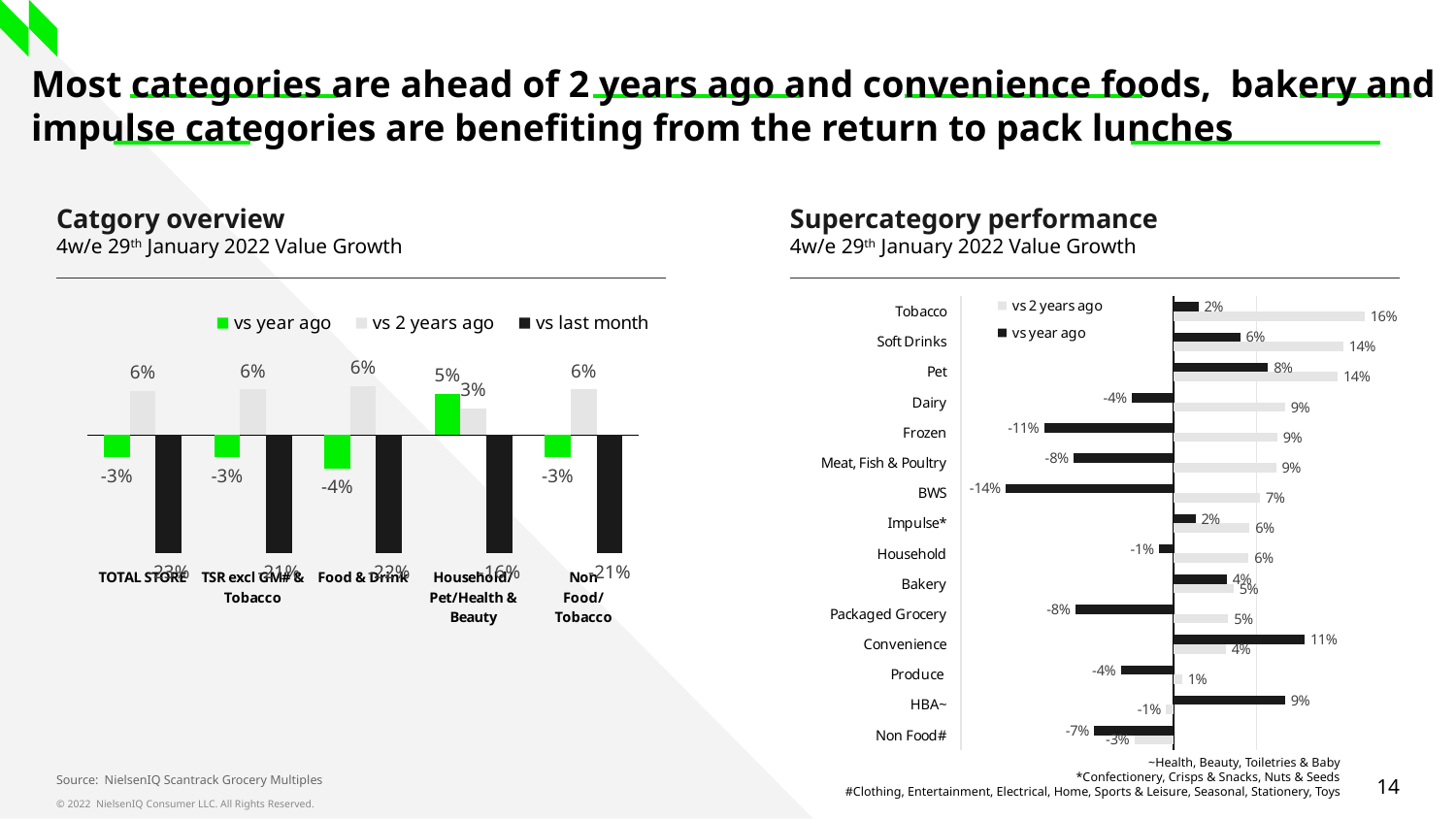
How many series does the legend of the Catgory overview chart list? 3 In the Supercategory performance chart, which is larger for vs year ago: Soft Drinks or Pet? Pet In the Supercategory performance chart, which category has the highest vs year ago value? Convenience In the Supercategory performance chart, what is the difference between the vs 2 years ago and vs year ago values for Pet? 6 percentage points How many categories are shown in the Supercategory performance chart? 15 In the Supercategory performance chart, which category has the lowest vs year ago value? BWS In the Supercategory performance chart, what is the vs year ago value for BWS? -14% In the Supercategory performance chart, what is the vs 2 years ago value for Tobacco? 16% In the Catgory overview chart, what is the vs year ago value for Household/Pet/Health & Beauty? 5% How many series does the legend of the Supercategory performance chart list? 2 What type of chart is the Catgory overview chart? Bar chart In the Supercategory performance chart, which category has the highest vs 2 years ago value? Tobacco